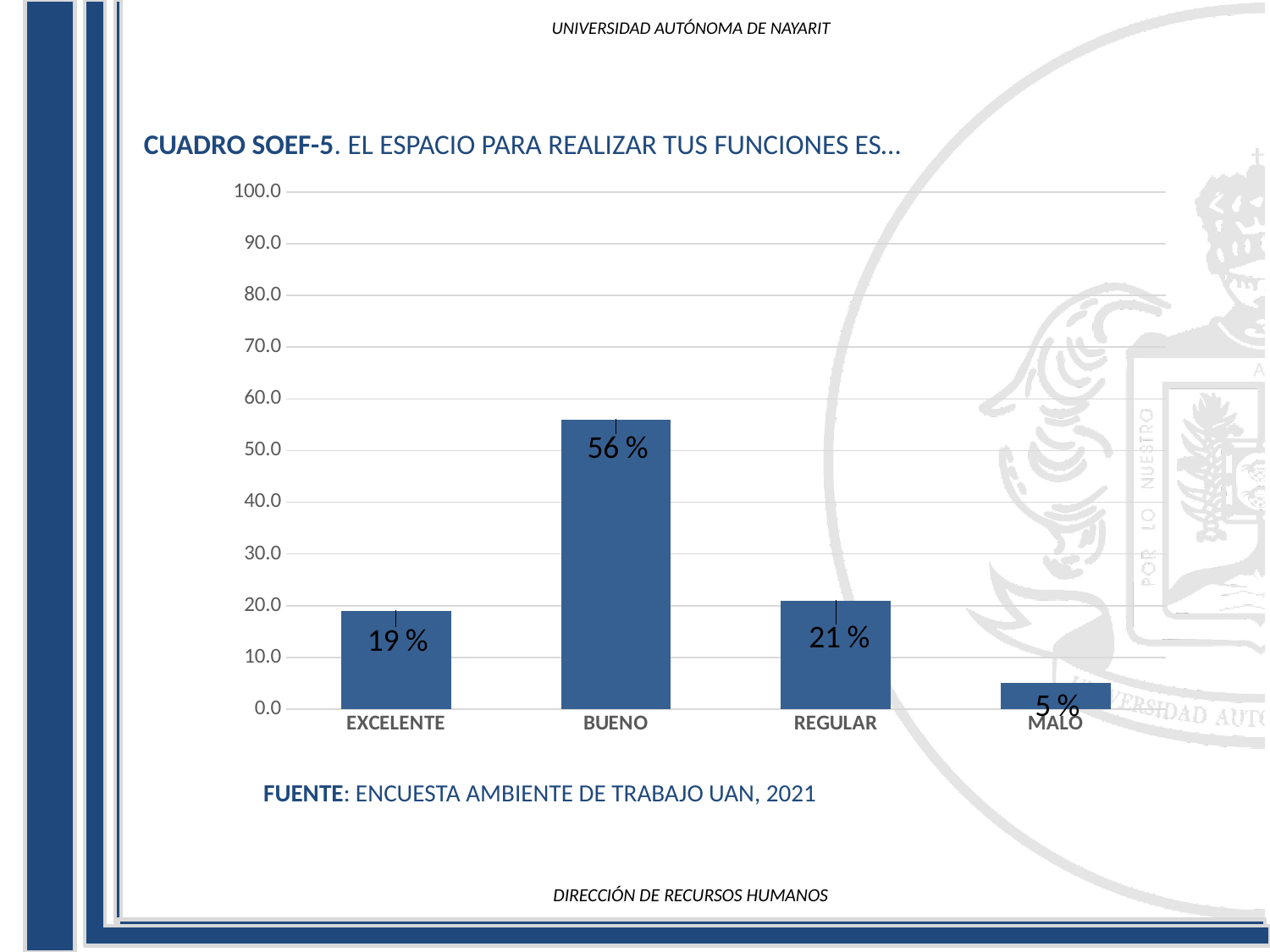
What is the value for BUENO? 56 % Which category has the highest value? BUENO What kind of chart is shown on the slide? bar chart Which category has the lowest value? MALO What is the value for MALO? 5 % Is the value for BUENO greater or less than 50.0? greater How many categories are shown on the x axis? 4 Which is larger, the value for EXCELENTE or the value for MALO? EXCELENTE What is the difference between the values for REGULAR and EXCELENTE? 2 % What is the difference between the values for BUENO and REGULAR? 35 % What is the value for REGULAR? 21 % What is the value for EXCELENTE? 19 %